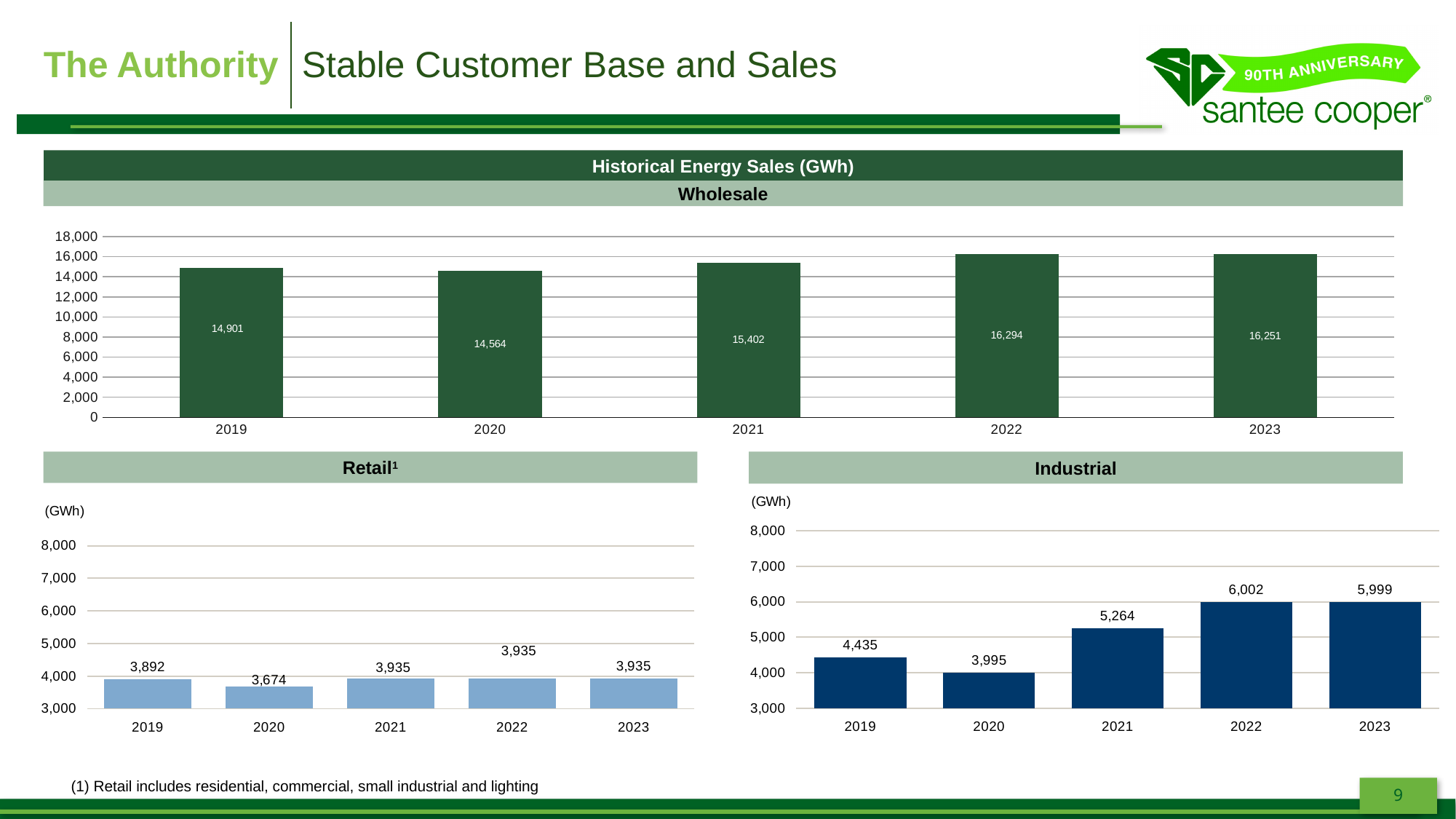
In the Wholesale chart, which year had the lowest value? 2020 How many years are shown in the Industrial chart? 5 In the Wholesale chart, which year had the highest value? 2022 What type of chart is the Wholesale chart? Bar chart In the Industrial chart, what was the value for 2021? 5,264 In the Retail chart, what was the value for 2020? 3,674 In the Wholesale chart, what was the value for 2021? 15,402 In the Industrial chart, which is larger, the value for 2019 or the value for 2020? 2019 In the Retail chart, which year had the lowest value? 2020 In the Retail chart, what is the difference between the 2019 and 2020 values? 218 In the Industrial chart, which year had the highest value? 2022 In the Wholesale chart, what is the difference between the 2022 and 2019 values? 1,393